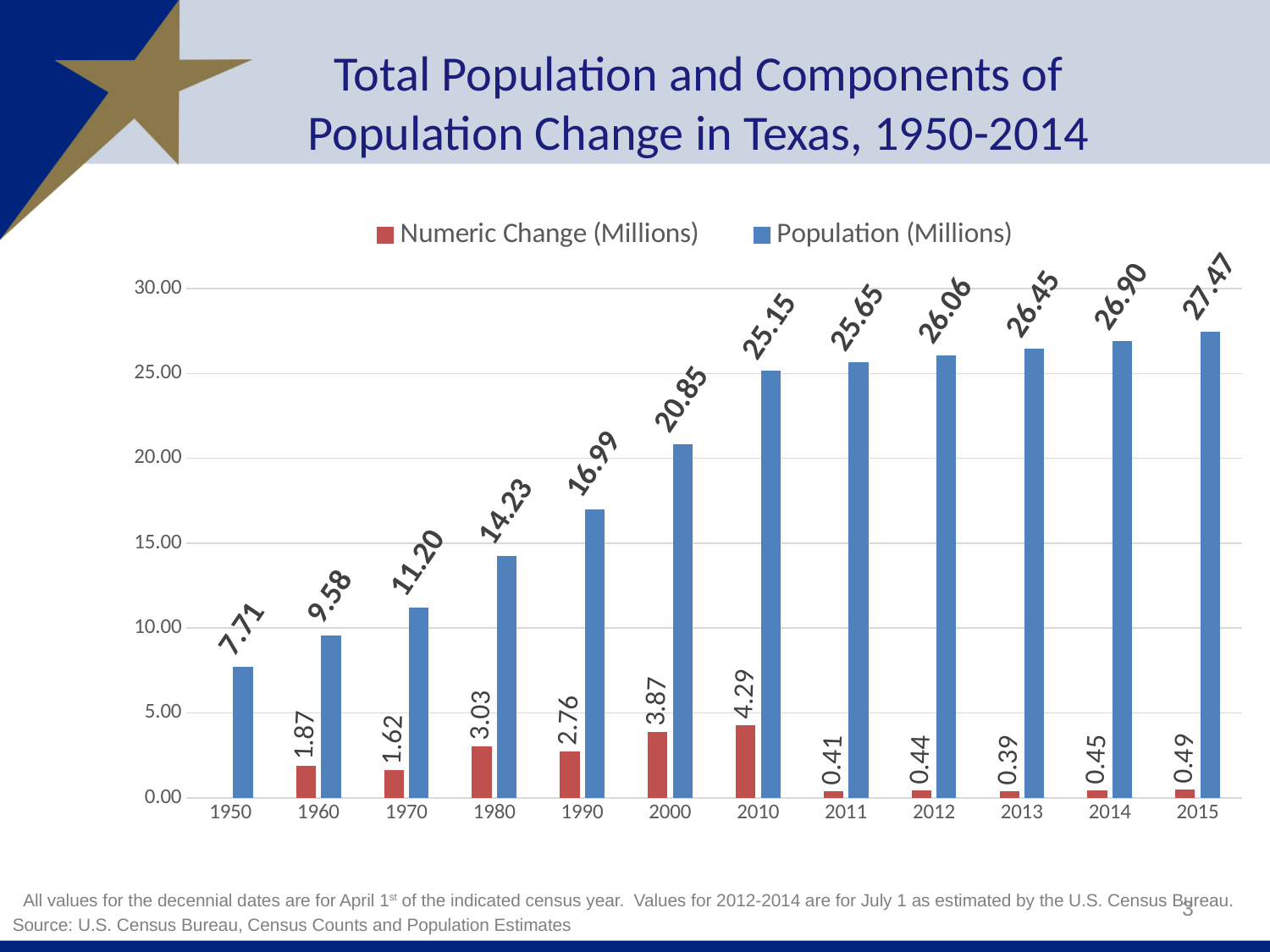
What is the Population (Millions) value for 2000? 20.85 How many series does the legend list? 2 Which year has the highest Population (Millions) value? 2015 What kind of chart is shown on the slide? bar chart Which is larger, the Numeric Change (Millions) for 1980 or for 1990? 1980 What is the Numeric Change (Millions) value for 2013? 0.39 How many years are shown on the x axis? 12 What is the Population (Millions) value for 1950? 7.71 Which year has the lowest Numeric Change (Millions) value? 2013 What is the difference between the Population (Millions) values for 2015 and 2010? 2.32 Is the Population (Millions) value for 1990 greater or less than 15.00? greater What is the Numeric Change (Millions) value for 2010? 4.29